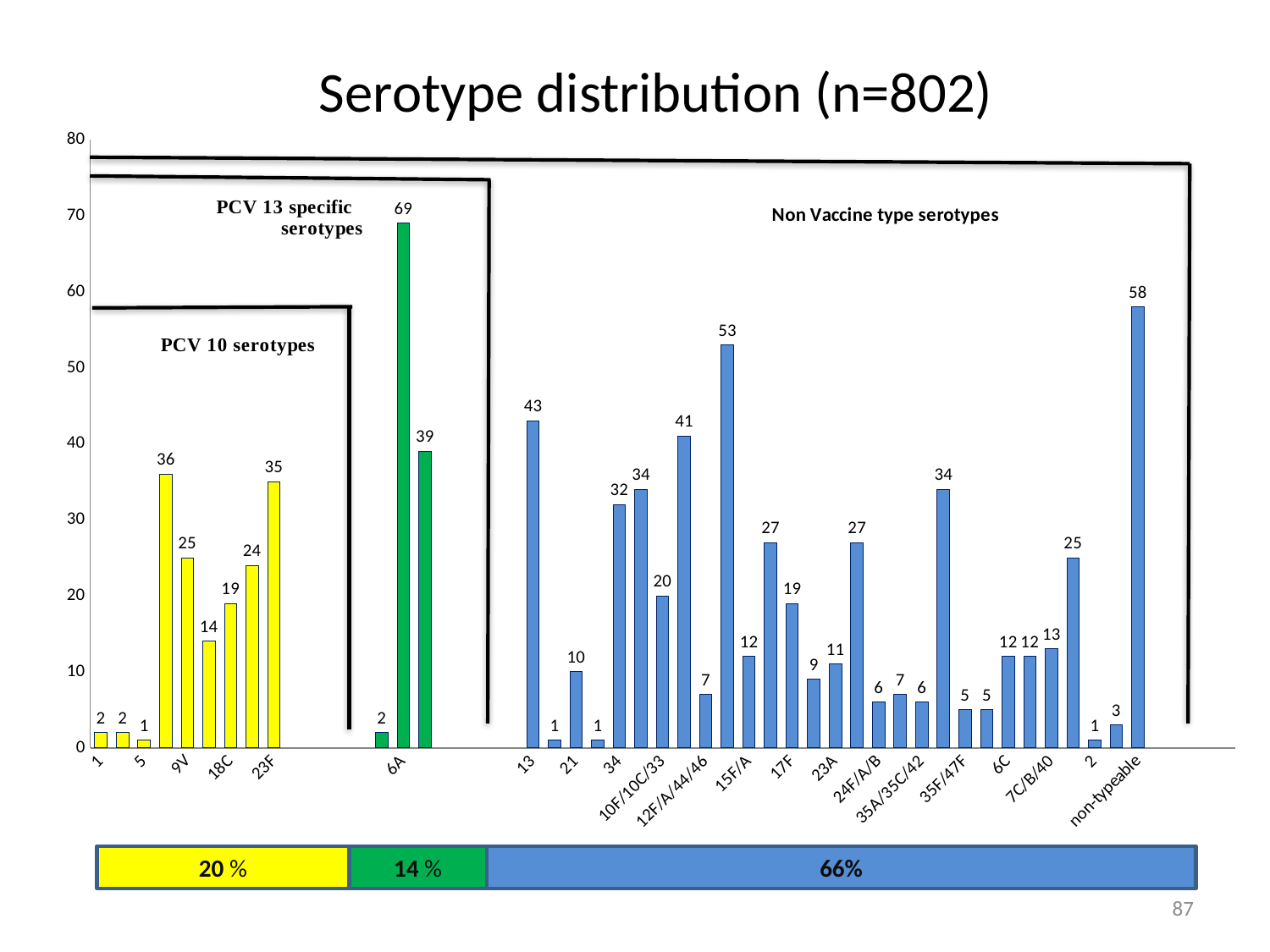
Which serotype has the highest bar among the Non Vaccine type serotypes? non-typeable What is the difference between the bar for 6A and the bar for non-typeable? 11 Which is larger, the bar for serotype 13 or the bar for serotype 23F? 13 What percentage is shown for the Non Vaccine type serotypes in the bar below the chart? 66% What percentage is shown for the PCV 13 specific serotypes in the bar below the chart? 14 % What is the value of the bar for non-typeable? 58 Which serotype has the highest bar in the chart? 6A What is the value of the bar for serotype 13? 43 What is the value of the bar for serotype 6A? 69 What is the value of the bar for serotype 23F? 35 What is the value of the bar for serotype 9V? 25 What kind of chart is shown on the slide? bar chart